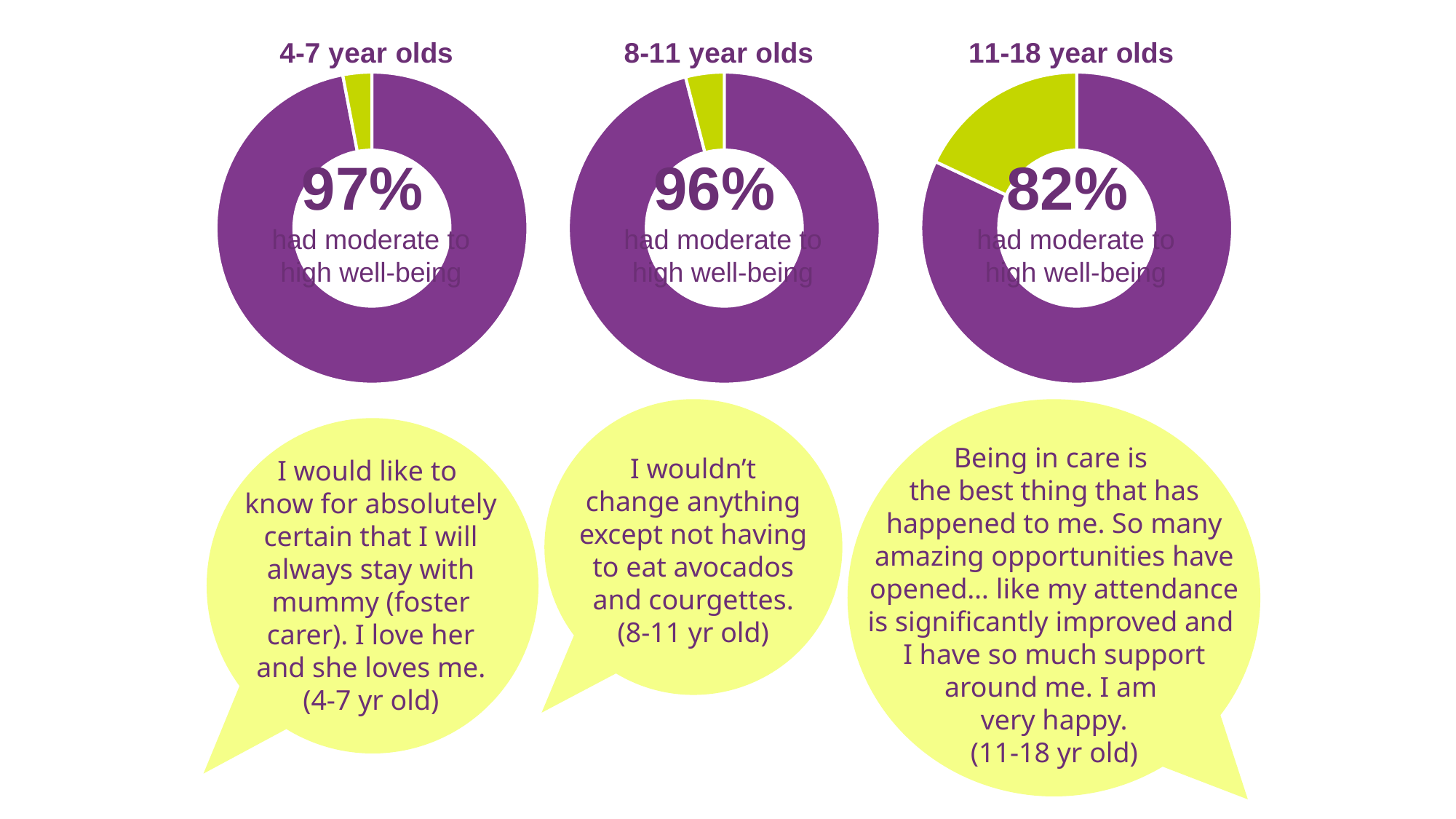
How many charts are shown on the slide? 3 What kind of chart is used for each age group on this slide? Donut (pie) chart In the 8-11 year olds chart, what percentage had moderate to high well-being? 96% Which is larger: the percentage in the 8-11 year olds chart or the 11-18 year olds chart? 8-11 year olds In the 11-18 year olds chart, what share of the ring does the purple slice represent? 82% What colour is the slice representing those with moderate to high well-being in each chart? Purple In the 4-7 year olds chart, what percentage had moderate to high well-being? 97% What is the difference between the percentage shown in the 8-11 year olds chart and the 11-18 year olds chart? 14% Which age group chart shows the highest percentage with moderate to high well-being? 4-7 year olds What is the difference between the percentage shown in the 4-7 year olds chart and the 11-18 year olds chart? 15% In the 11-18 year olds chart, what percentage had moderate to high well-being? 82% Which age group chart shows the lowest percentage with moderate to high well-being? 11-18 year olds